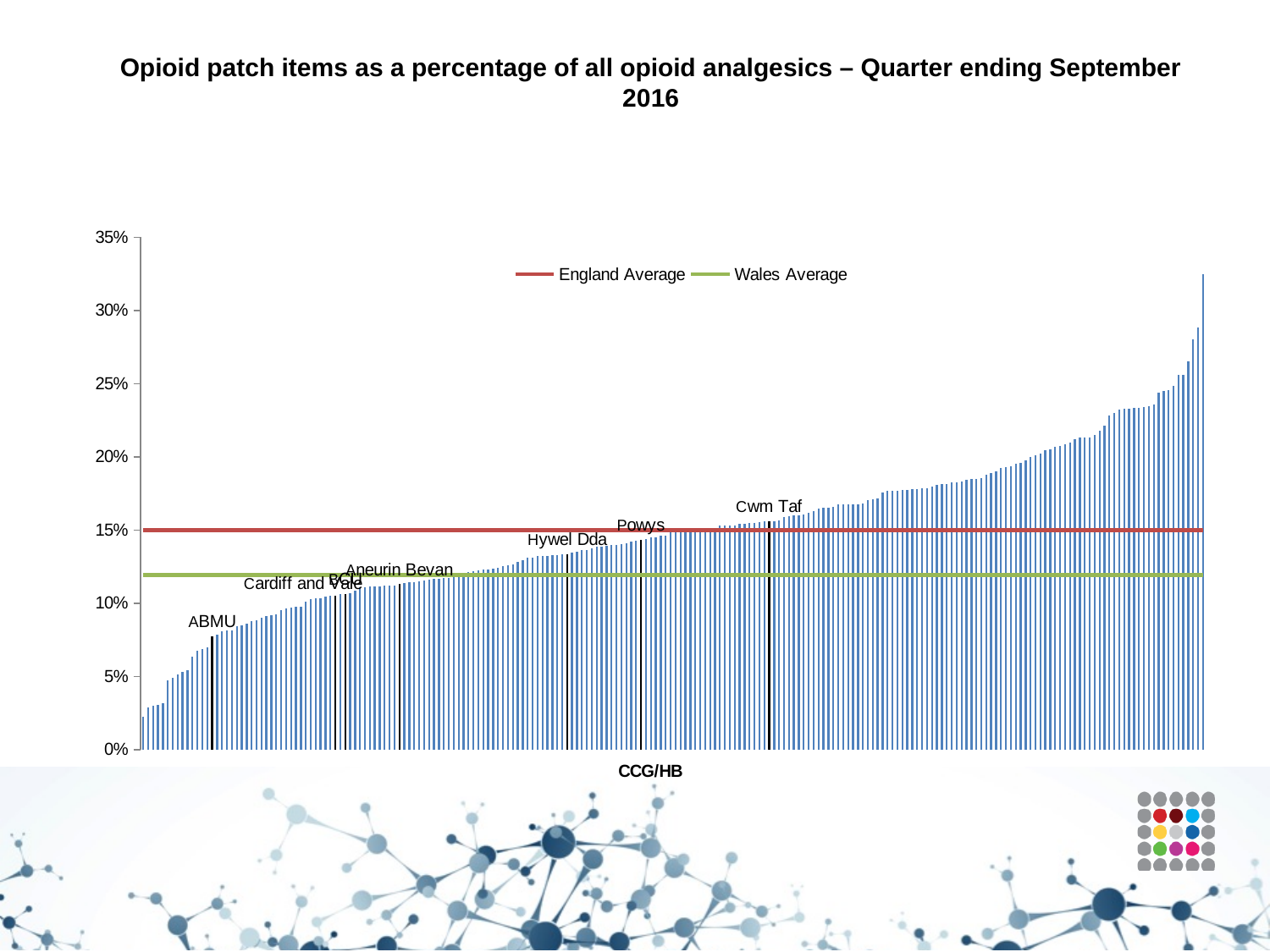
Is the value for Aneurin Bevan greater or less than 15%? less Is the value for Cwm Taf greater or less than 10%? greater Do the bar values rise or fall moving from left to right along the x axis? rise Is the value for Cardiff and Vale greater or less than 5%? greater What is the title of the chart? Opioid patch items as a percentage of all opioid analgesics – Quarter ending September 2016 Of the labelled Welsh health boards, which has the lowest value? ABMU What is the label on the x axis of the chart? CCG/HB How many entries does the chart legend list? 2 Which has the larger value, ABMU or Cwm Taf? Cwm Taf What kind of chart is shown on the slide? bar chart